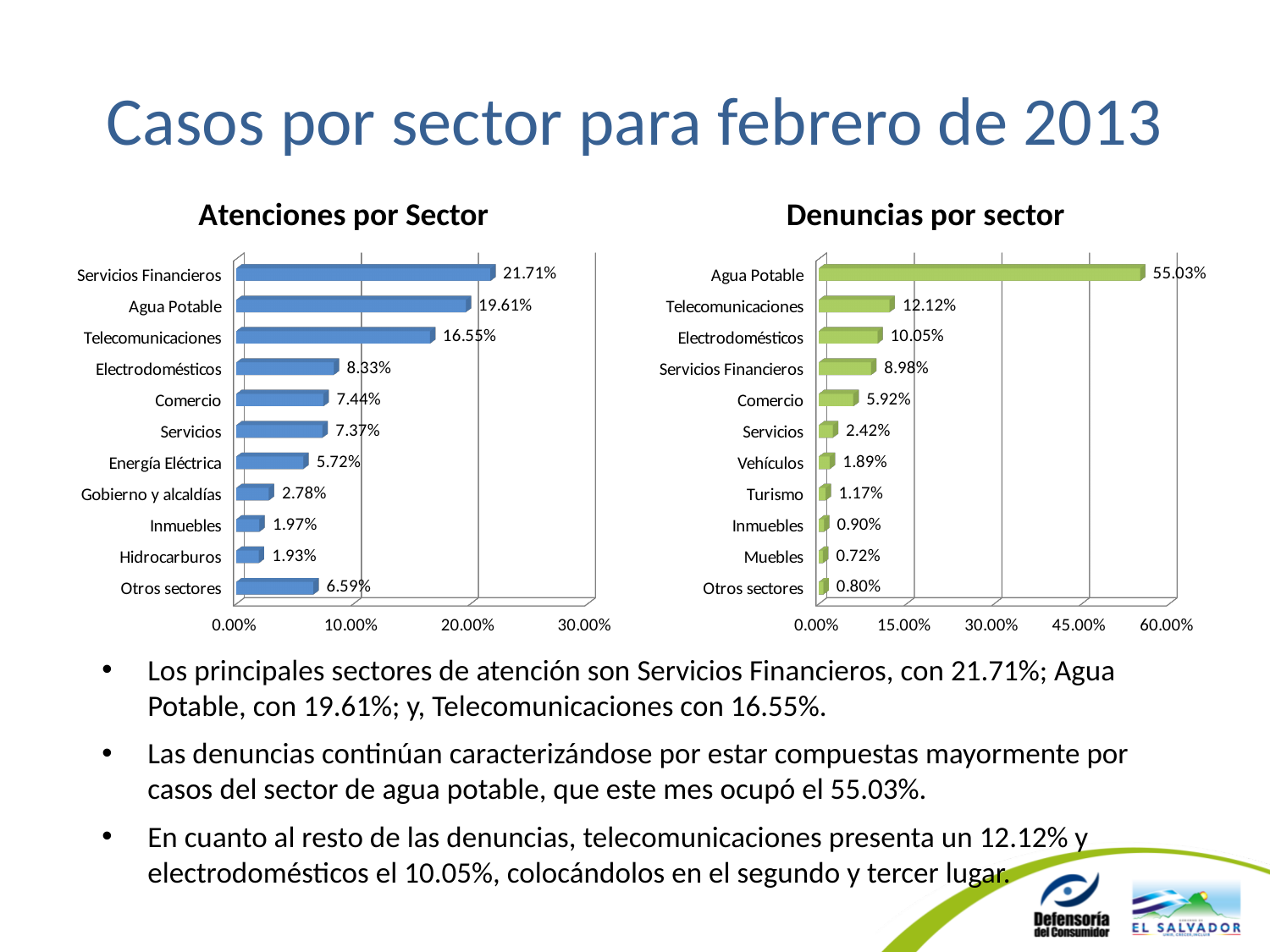
What type of chart is 'Atenciones por Sector'? Bar chart In the 'Atenciones por Sector' chart, which is larger: Comercio or Electrodomésticos? Electrodomésticos In the 'Denuncias por sector' chart, what is the value for Agua Potable? 55.03% In the 'Denuncias por sector' chart, what is the value for Turismo? 1.17% In the 'Denuncias por sector' chart, what is the difference between Telecomunicaciones and Electrodomésticos? 2.07% In the 'Atenciones por Sector' chart, what is the difference between Servicios Financieros and Agua Potable? 2.10% In the 'Denuncias por sector' chart, which sector has the highest value? Agua Potable How many sectors are shown in the 'Denuncias por sector' chart? 11 In the 'Atenciones por Sector' chart, what is the value for Energía Eléctrica? 5.72% What is the title of the chart on the right side of the slide? Denuncias por sector In the 'Atenciones por Sector' chart, which sector has the lowest value? Hidrocarburos In the 'Atenciones por Sector' chart, what is the value for Servicios Financieros? 21.71%